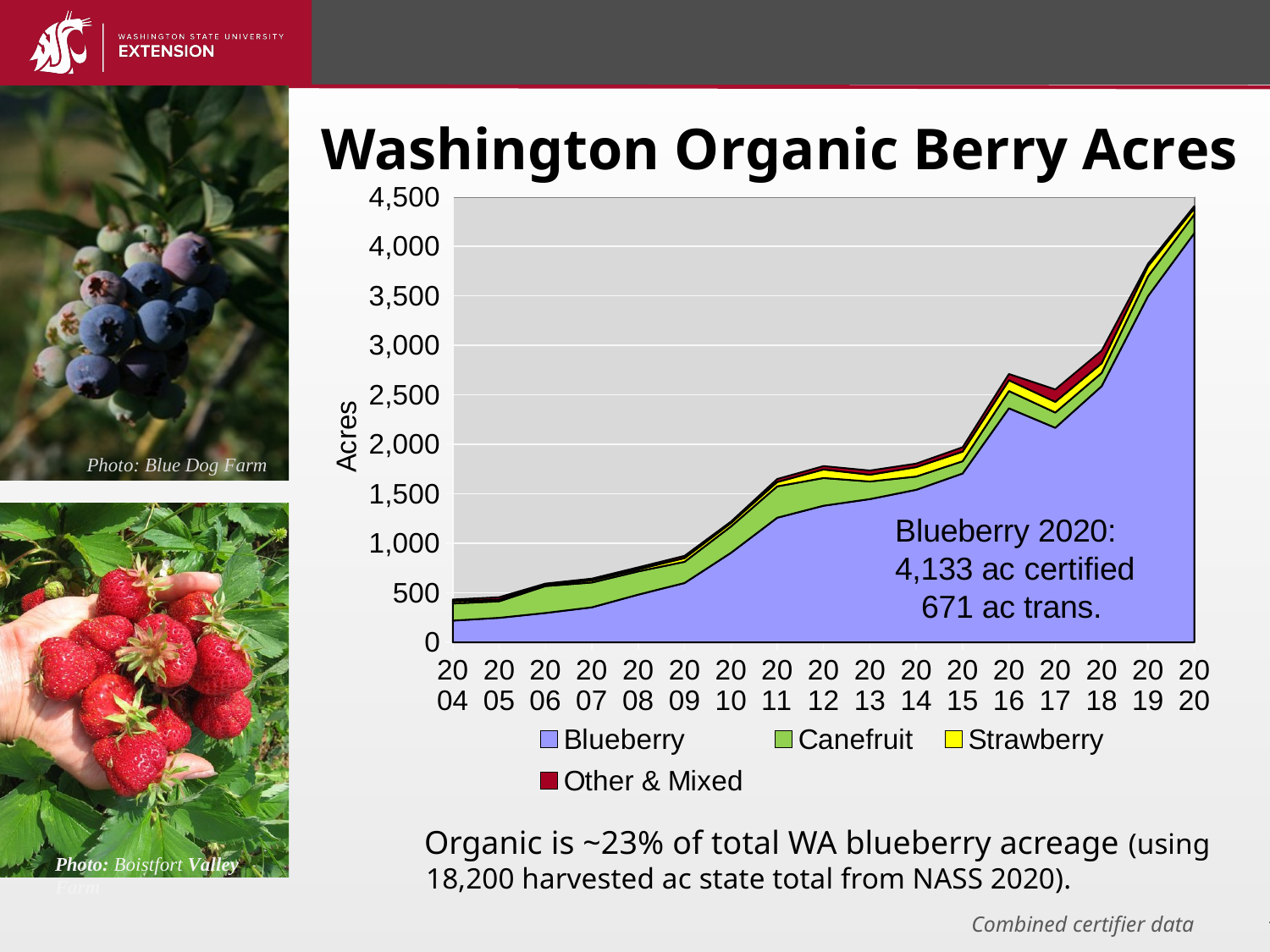
In which year is the total organic berry acreage highest? 2020 How many years are plotted along the x axis? 17 Do total organic berry acres generally rise or fall from 2004 to 2020? Rise Which series is shown in yellow in the chart? Strawberry What kind of chart is shown on the slide? Stacked area chart How many series does the legend list? 4 Is the Blueberry acreage in 2016 greater or less than 2,000? greater What is the label on the y axis of the chart? Acres Is the total organic berry acreage in 2004 greater or less than 500? less In which year is the total organic berry acreage lowest? 2004 According to the annotation on the chart, how many certified acres of organic blueberry were there in 2020? 4,133 ac Is the total organic berry acreage in 2020 greater or less than 4,000? greater